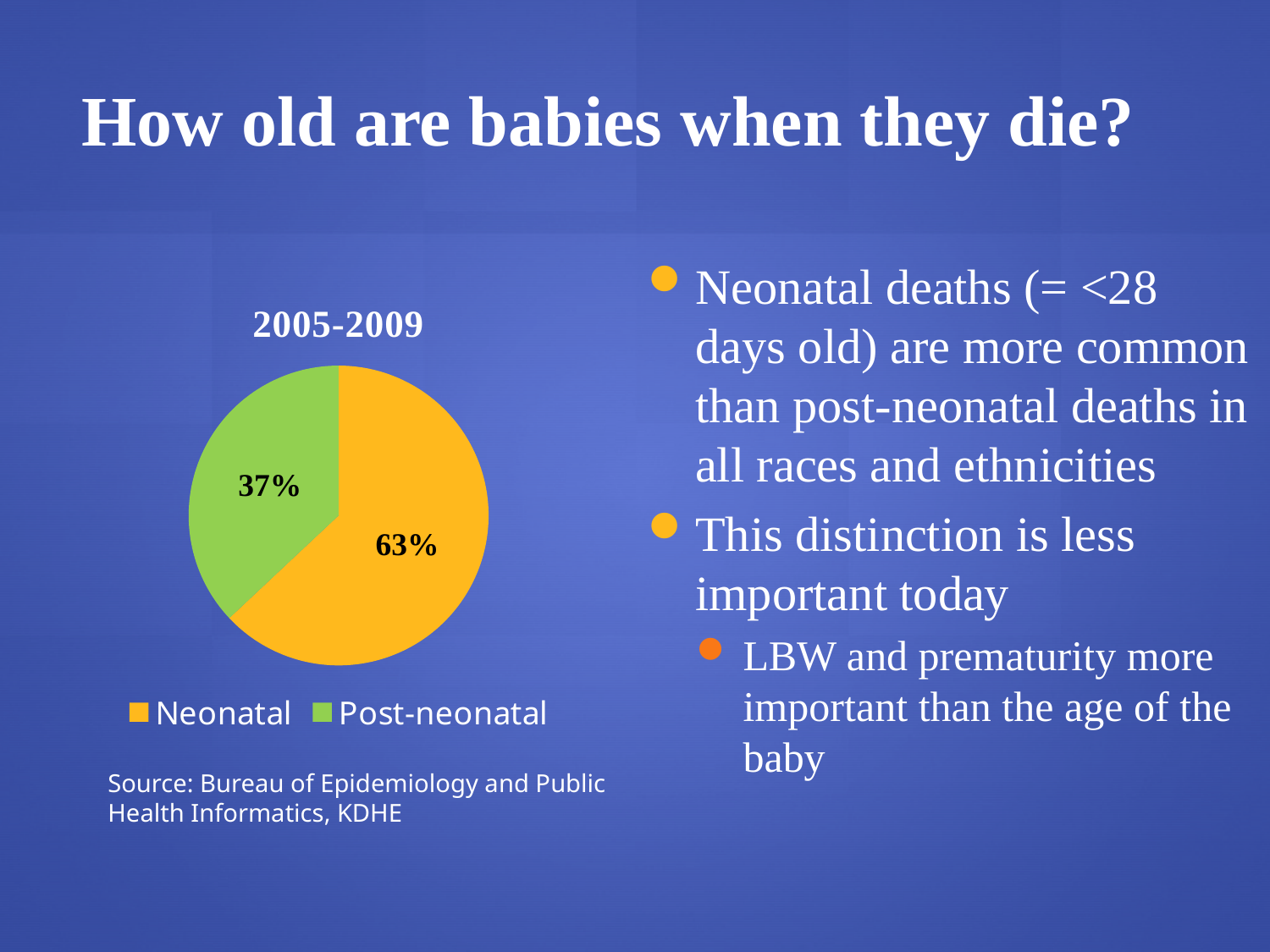
What share of the pie is Post-neonatal? 37% Which is larger, the Neonatal slice or the Post-neonatal slice? Neonatal What colour is the Post-neonatal slice? green What share of the pie is Neonatal? 63% Which slice of the pie is the largest? Neonatal How many entries does the legend list? 2 What kind of chart is shown on the slide? pie chart How many slices does the pie chart have? 2 What is the chart's title? 2005-2009 What is the difference in percentage points between the Neonatal and Post-neonatal slices? 26 Which slice of the pie is the smallest? Post-neonatal